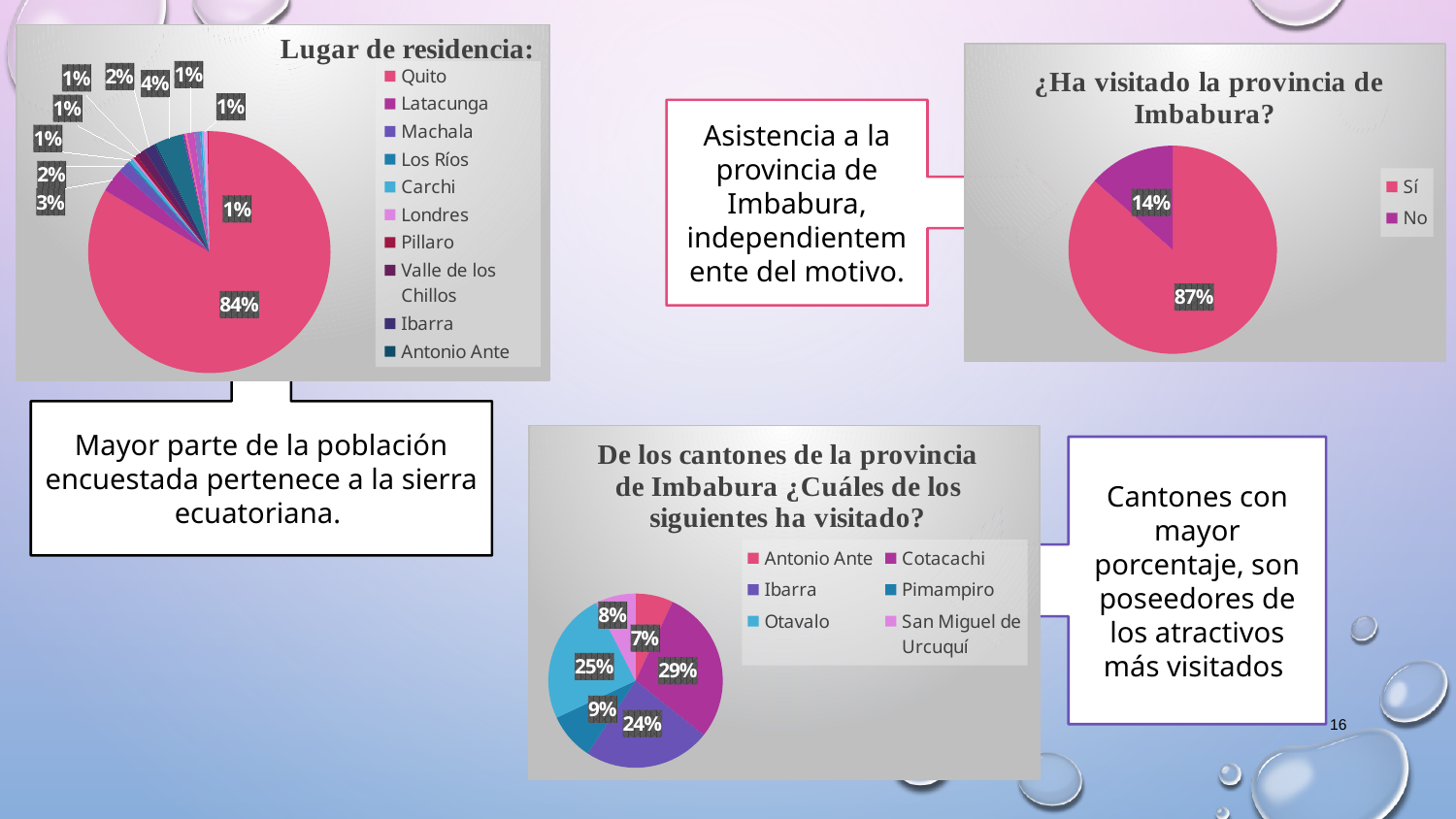
In the 'Lugar de residencia' chart, which place of residence has the largest slice? Quito What kind of chart is the 'Lugar de residencia' chart? Pie chart How many places of residence does the legend of the 'Lugar de residencia' chart list? 10 In the 'De los cantones de la provincia de Imbabura' chart, what is the difference between the Ibarra and Pimampiro shares? 15% In the 'Lugar de residencia' chart, what share of respondents live in Quito? 84% In the 'De los cantones de la provincia de Imbabura' chart, what share of respondents visited Cotacachi? 29% In the '¿Ha visitado la provincia de Imbabura?' chart, what percentage answered 'No'? 14% In the 'De los cantones de la provincia de Imbabura' chart, which is larger, the share for Ibarra or for San Miguel de Urcuquí? Ibarra In the 'De los cantones de la provincia de Imbabura' chart, which canton has the smallest slice? Antonio Ante In the '¿Ha visitado la provincia de Imbabura?' chart, how many categories does the legend list? 2